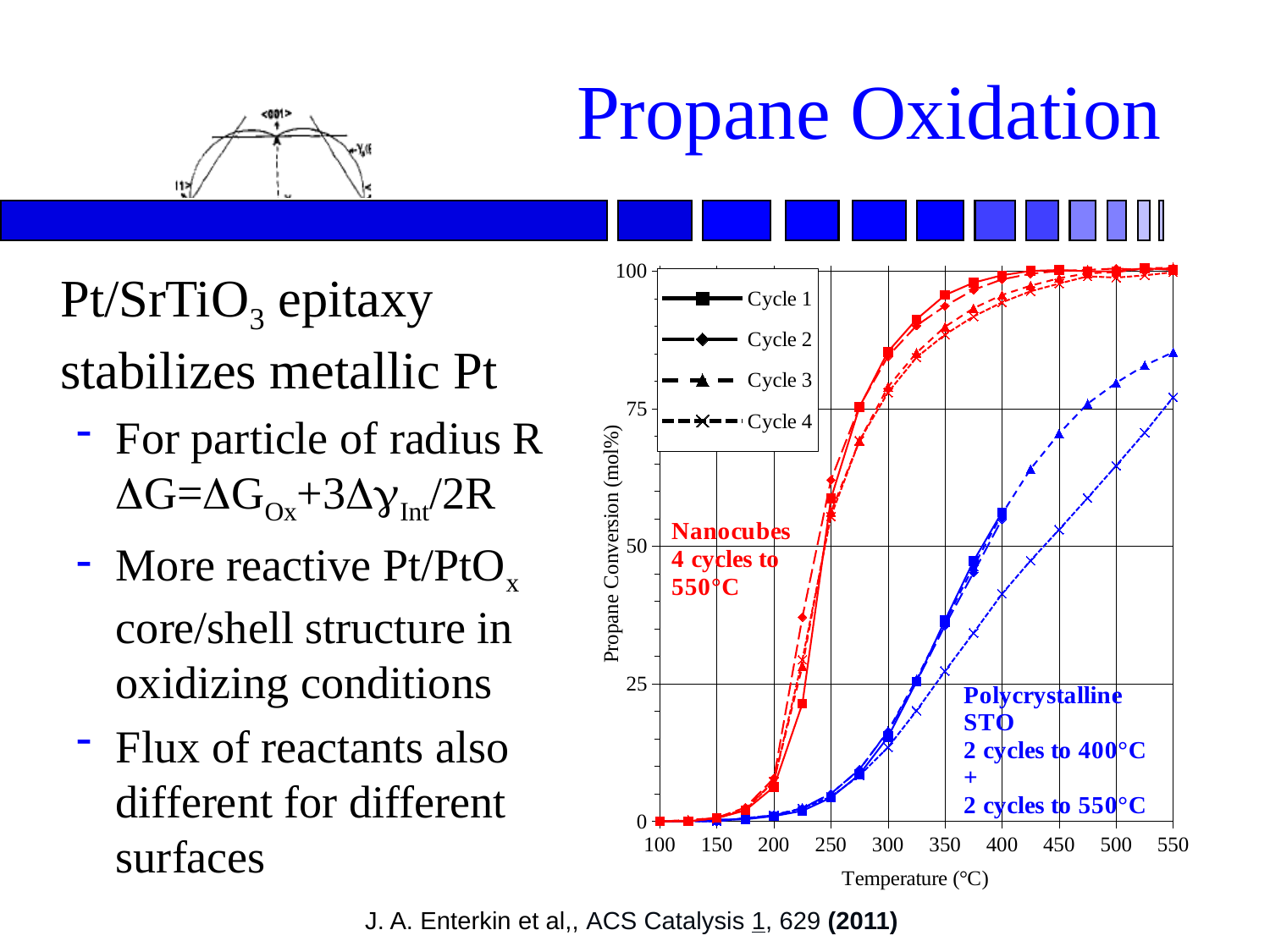
What is the label of the y axis of the chart? Propane Conversion (mol%) Is the propane conversion of the Nanocubes (red) curves at 200°C greater or less than 25? less Is the propane conversion of the Nanocubes (red) curves at 300°C greater or less than 75? greater Does propane conversion rise or fall as temperature increases along the x axis? rise Which sample reaches the higher propane conversion at 550°C, Nanocubes or Polycrystalline STO? Nanocubes Is the propane conversion of the Nanocubes (red) curves at 250°C greater or less than 50? greater How many series does the chart legend list? 4 At 300°C, which sample shows higher propane conversion, Nanocubes or Polycrystalline STO? Nanocubes What kind of chart is shown on the slide? line chart What are the four series named in the chart legend? Cycle 1, Cycle 2, Cycle 3, Cycle 4